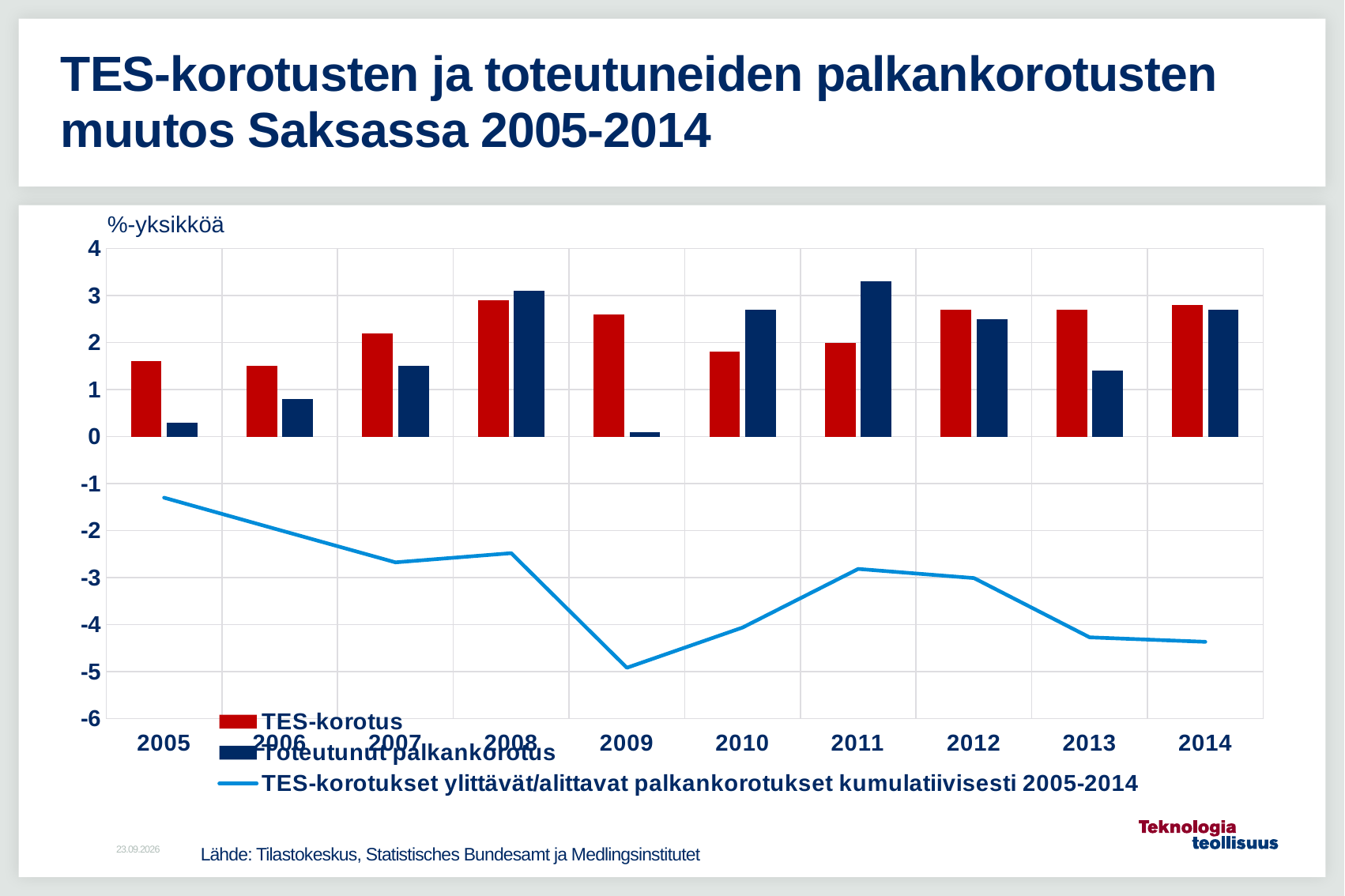
In 2013, which is larger: TES-korotus or Toteutunut palkankorotus? TES-korotus Does the cumulative line rise or fall from 2011 to 2014? Falls Which year has the lowest value for Toteutunut palkankorotus? 2009 In which year does the line 'TES-korotukset ylittävät/alittavat palkankorotukset kumulatiivisesti 2005-2014' reach its lowest point? 2009 How many series does the legend list? 3 Which year has the highest value for Toteutunut palkankorotus? 2011 In 2011, which is larger: TES-korotus or Toteutunut palkankorotus? Toteutunut palkankorotus How many years are shown on the x axis? 10 Is the value for TES-korotus in 2008 greater or less than 2? greater What kind of chart is shown on the slide? A combined bar and line chart Is the value for Toteutunut palkankorotus in 2009 greater or less than 1? less Is the value of the cumulative line in 2009 greater or less than -4? less